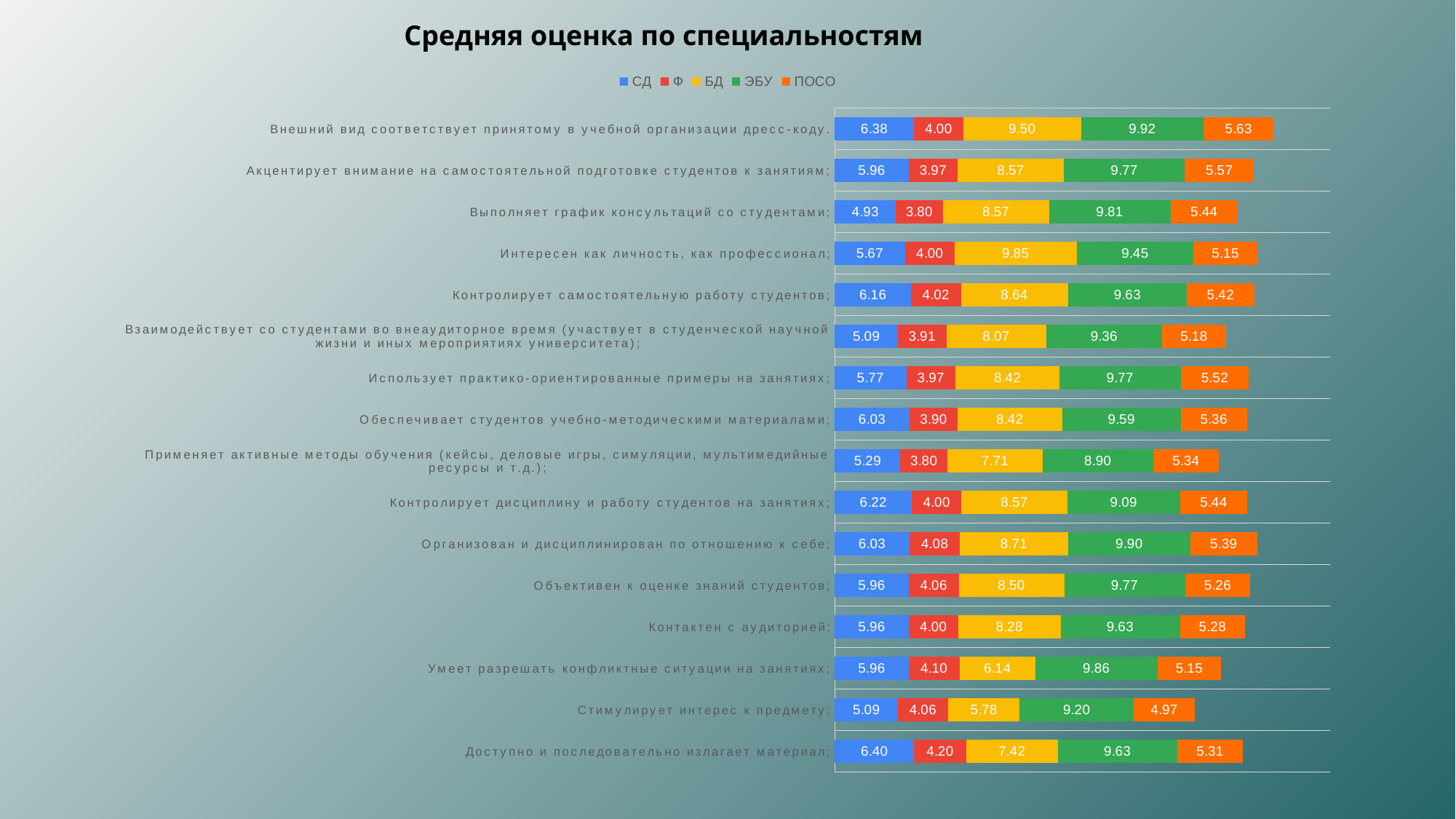
Which category has the larger БД value: "Умеет разрешать конфликтные ситуации на занятиях;" or "Контактен с аудиторией;"? Контактен с аудиторией; What is the value for ЭБУ in the category "Организован и дисциплинирован по отношению к себе;"? 9.90 Which category has the lowest value for БД? Стимулирует интерес к предмету; What is the value for СД in the category "Внешний вид соответствует принятому в учебной организации дресс-коду."? 6.38 What is the difference between the ЭБУ and Ф values in the category "Внешний вид соответствует принятому в учебной организации дресс-коду."? 5.92 What kind of chart is shown on the slide? Stacked bar chart How many series does the legend list? 5 Which category has the highest value for СД? Доступно и последовательно излагает материал; How many categories are shown in the chart? 16 Which category has the highest value for БД? Интересен как личность, как профессионал; What is the value for ПОСО in the category "Стимулирует интерес к предмету;"? 4.97 What is the total of the stacked bar for "Стимулирует интерес к предмету;"? 29.10